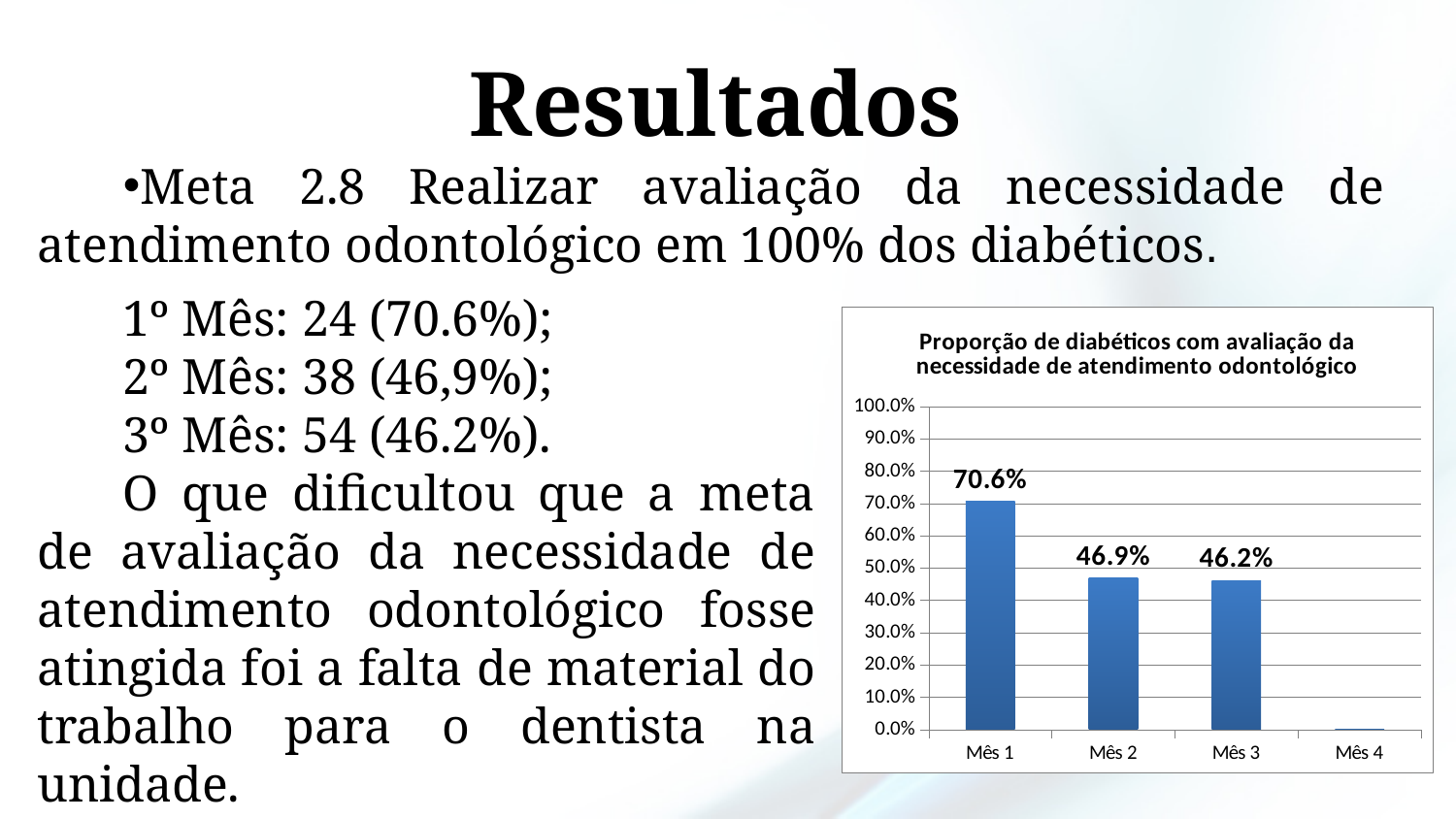
Which is larger, the value for Mês 2 or the value for Mês 3? Mês 2 Is the value for Mês 3 greater or less than 50.0%? less What is the value for Mês 1 in the chart? 70.6% What kind of chart is shown on the slide? Bar chart What is the value for Mês 3 in the chart? 46.2% What is the difference between the values for Mês 1 and Mês 2? 23.7 percentage points What is the difference between the values for Mês 1 and Mês 3? 24.4 percentage points How many categories are shown on the x axis of the chart? 4 What is the title of the chart? Proporção de diabéticos com avaliação da necessidade de atendimento odontológico Is the value for Mês 1 greater or less than 60.0%? greater Which month has the highest proportion in the chart? Mês 1 What is the value for Mês 2 in the chart? 46.9%